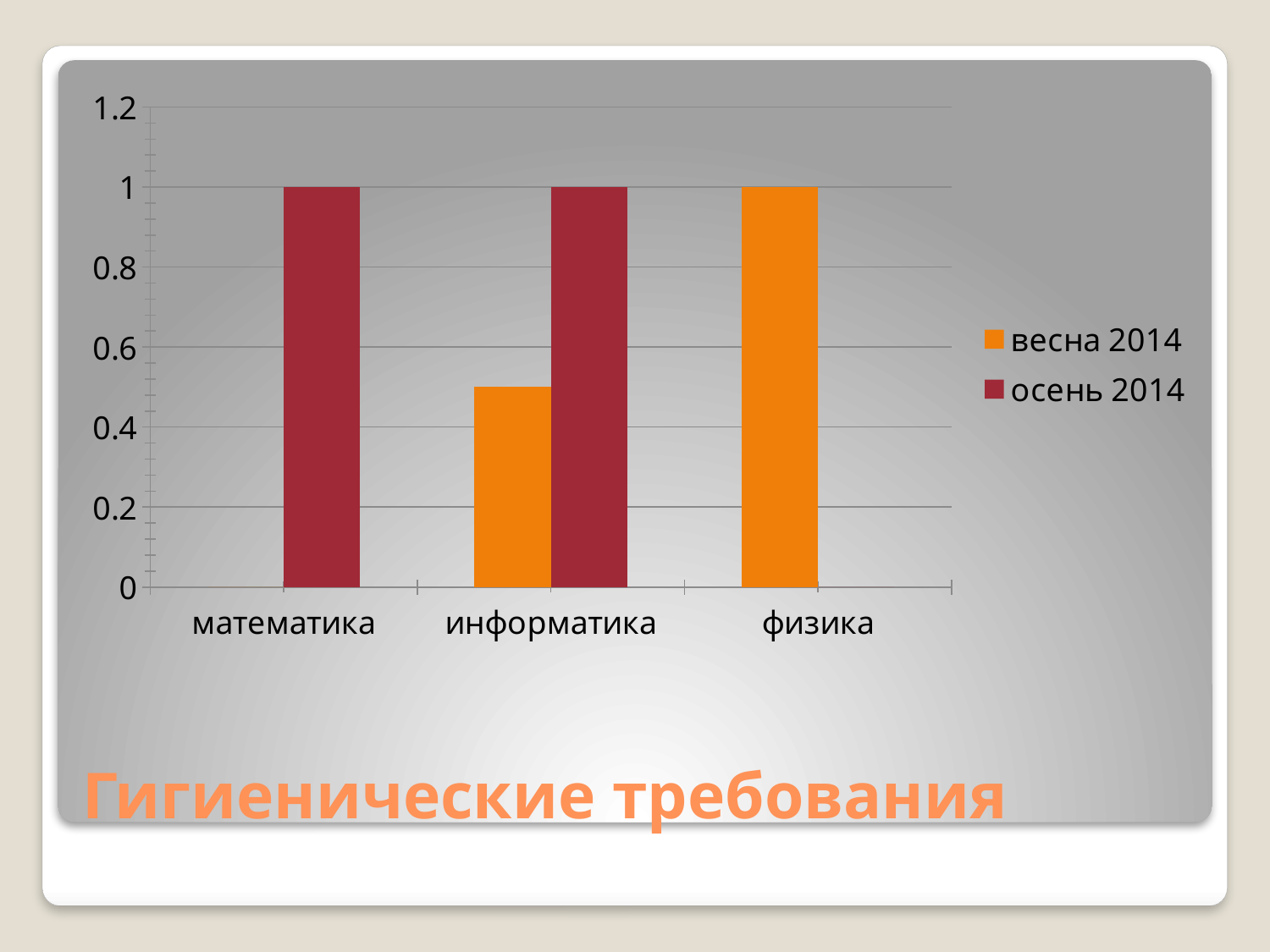
Is the value for весна 2014 in the информатика category greater or less than 0.6? less How many categories are shown on the x axis? 3 What is the value for осень 2014 in the информатика category? 1 What is the value for осень 2014 in the математика category? 1 In the информатика category, which series has the larger value, весна 2014 or осень 2014? осень 2014 How many series does the legend list? 2 What is the value for весна 2014 in the физика category? 1 What kind of chart is shown on the slide? bar chart What colour represents the весна 2014 series? orange What is the title of the slide with the chart? Гигиенические требования Which category has the highest value for the весна 2014 series? физика Is the value for весна 2014 in the информатика category greater or less than 0.4? greater